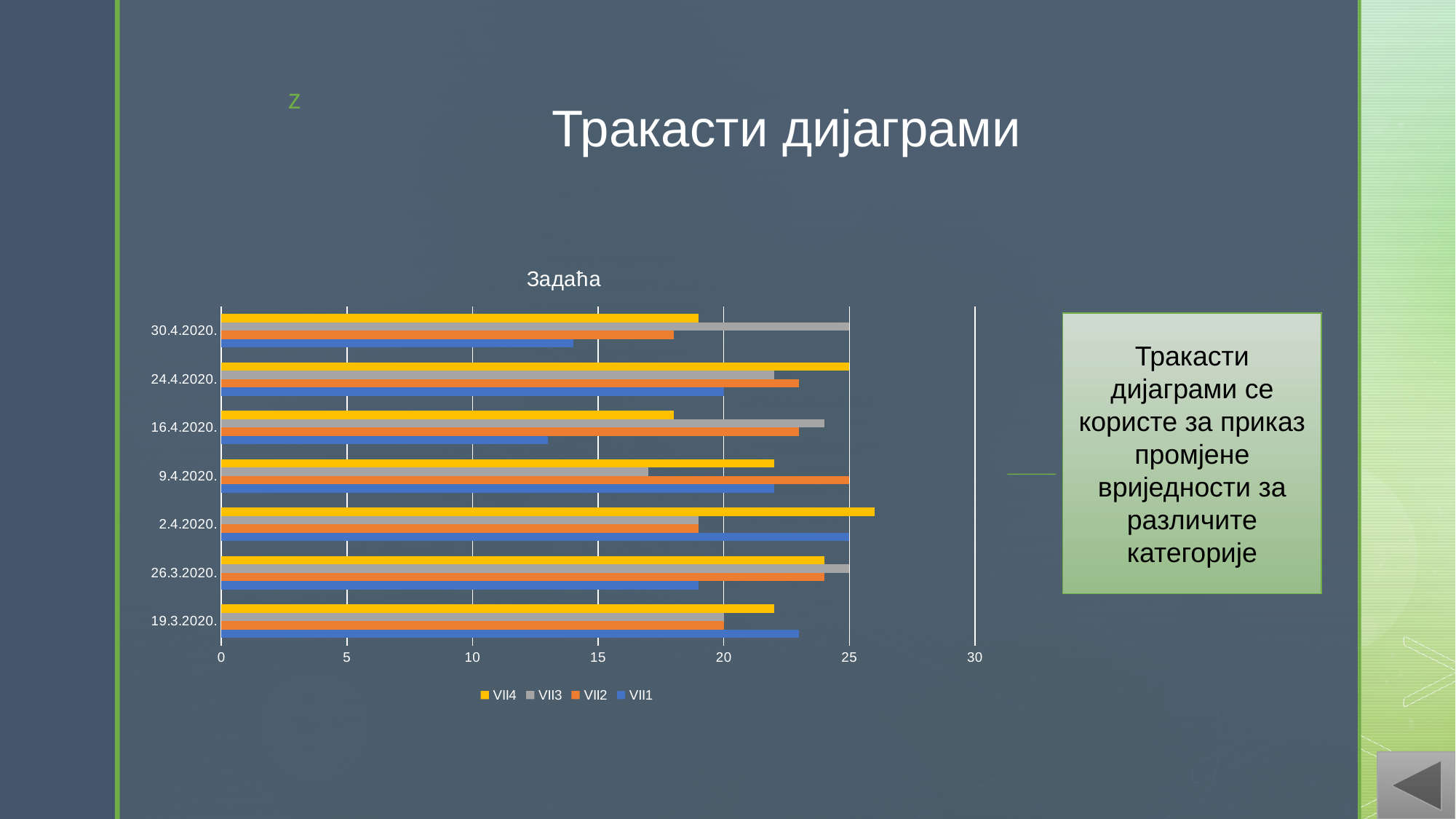
On 30.4.2020., which is larger: VII3 or VII1? VII3 What is the value for VII3 on 30.4.2020.? 25 What is the title of the chart? Задаћа What kind of chart is shown on the slide? bar chart Is the value for VII2 on 30.4.2020. greater or less than 20? less Is the value for VII1 on 16.4.2020. greater or less than 15? less Is the value for VII4 on 2.4.2020. greater or less than 25? greater On 16.4.2020., which is larger: VII3 or VII1? VII3 How many date categories are shown on the chart? 7 Which series are listed in the chart legend? VII4, VII3, VII2, VII1 How many series does the legend list? 4 What is the value for VII1 on 24.4.2020.? 20